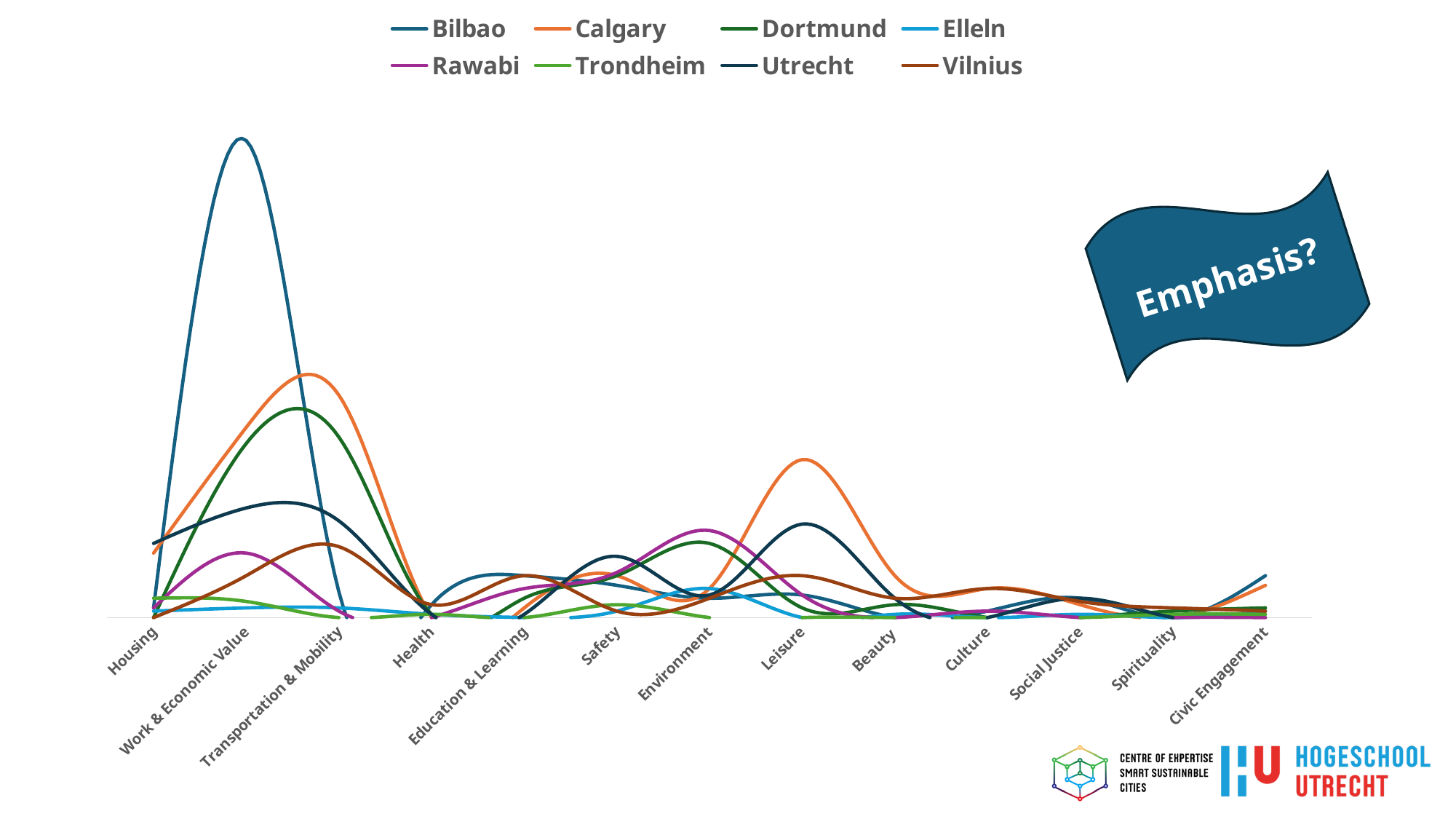
At Work & Economic Value, which is higher: Dortmund or Vilnius? Dortmund How many series does the chart's legend list? 8 At Work & Economic Value, which is higher: Calgary or Dortmund? Calgary What is the first category on the x axis of the chart? Housing At Leisure, which is higher: Calgary or Rawabi? Calgary For the Calgary series, which category has the highest value? Transportation & Mobility Which series has the highest value at Leisure? Calgary Does the Calgary series rise or fall from Leisure to Spirituality? fall How many categories are shown along the x axis of the chart? 13 What kind of chart is shown on the slide? line chart What text appears in the blue banner callout next to the chart? Emphasis?